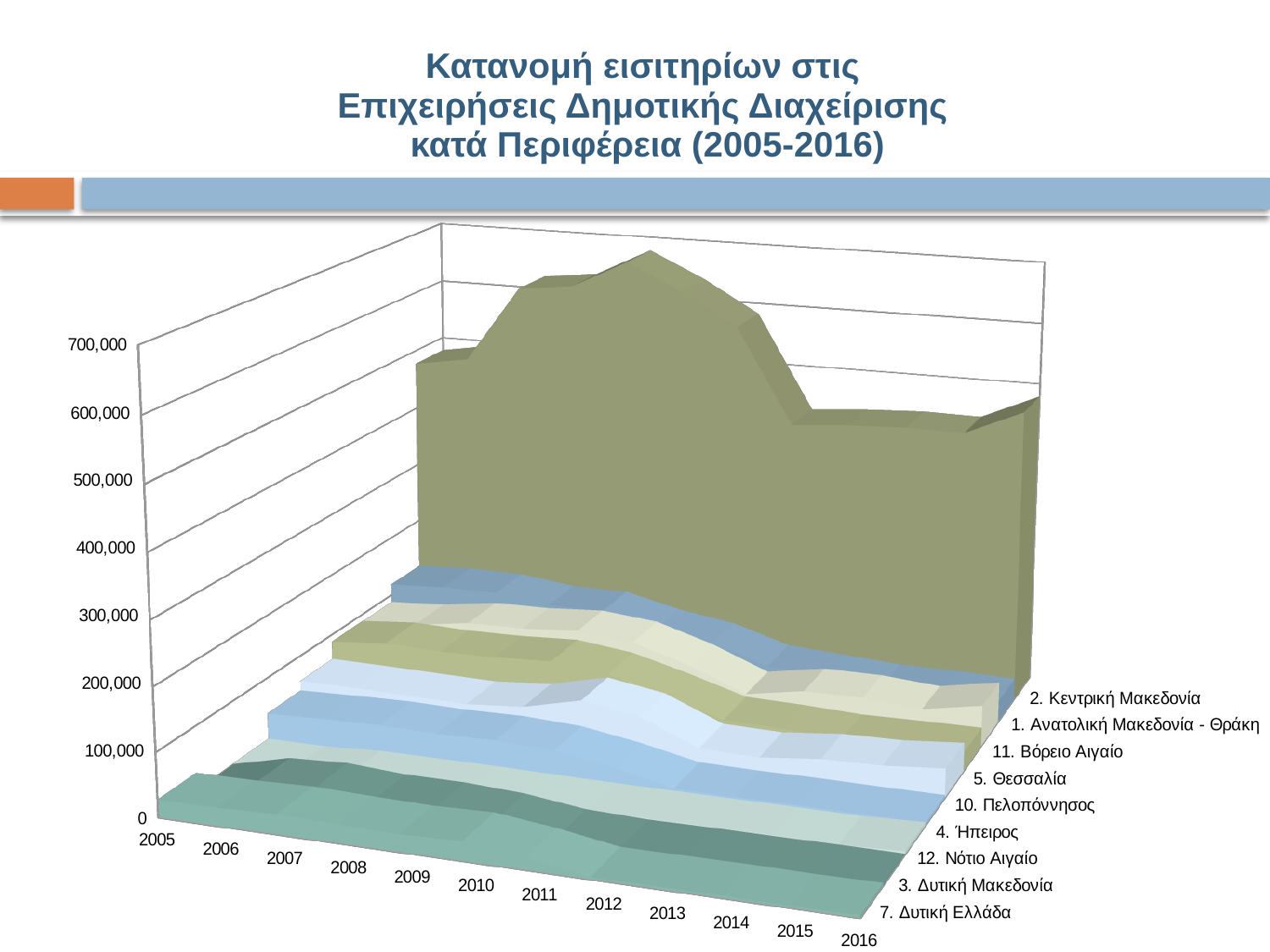
Do the values for 2. Κεντρική Μακεδονία rise or fall from 2011 to 2014? fall How many years are shown along the x axis of the chart? 12 What kind of chart is shown on the slide? area chart Which is larger in 2011: the value for 2. Κεντρική Μακεδονία or the value for 7. Δυτική Ελλάδα? 2. Κεντρική Μακεδονία Which region has the highest ticket values in the chart? 2. Κεντρική Μακεδονία Do the values for 2. Κεντρική Μακεδονία rise or fall from 2005 to 2011? rise What is the highest value labelled on the vertical axis? 700,000 How many regions (series) are plotted in the chart? 9 What is the first year shown on the x axis? 2005 Which region's series is plotted at the very front of the chart? 7. Δυτική Ελλάδα